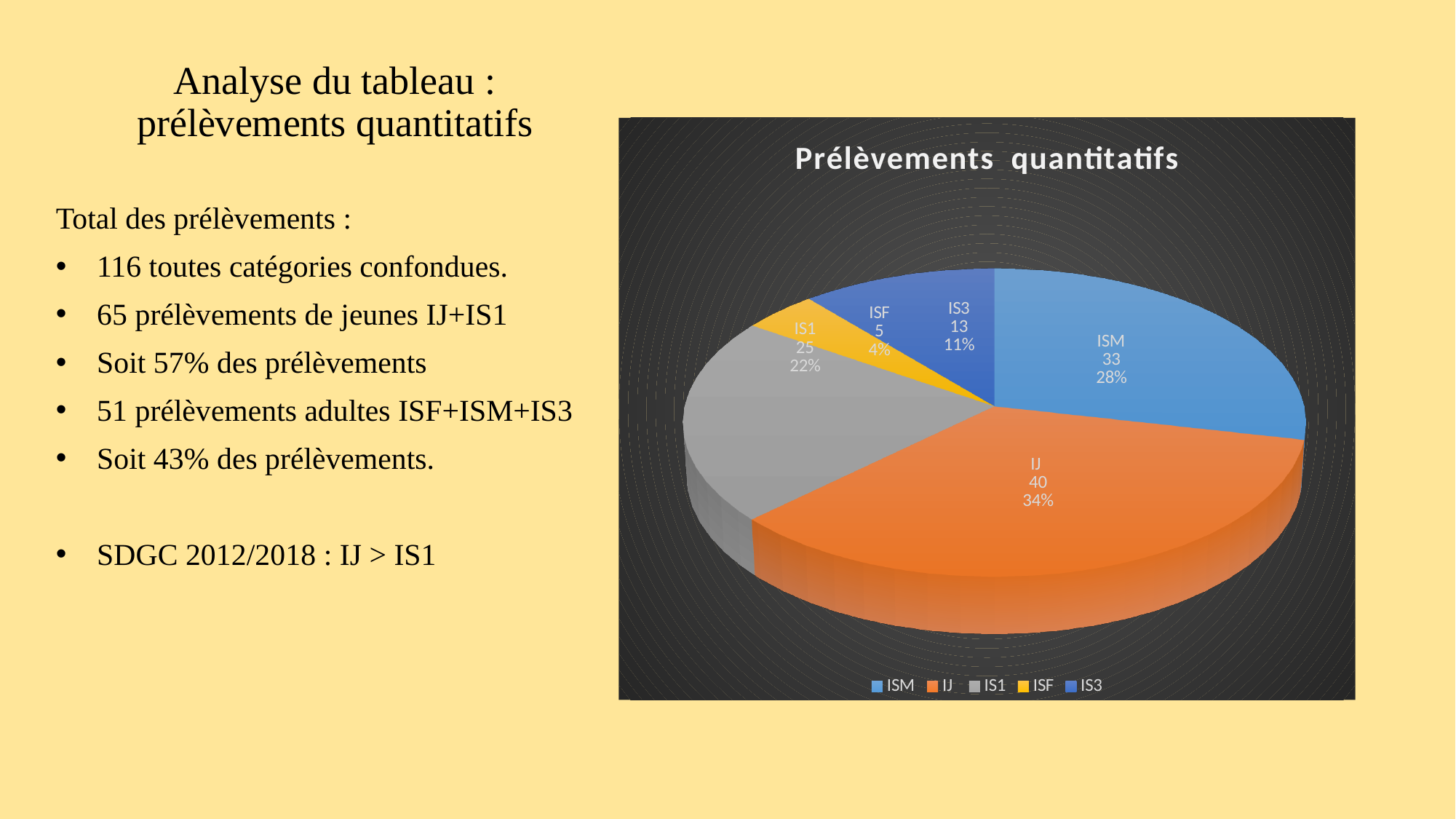
Which category has the smallest slice? ISF What is the difference between the values for IJ and IS1? 15 What kind of chart is shown on the slide? Pie chart Which category has the largest slice? IJ What is the value for IS1? 25 What is the value for IJ? 40 What share of the pie does IS3 represent? 11% How many categories does the pie chart have? 5 Which is larger, the value for ISM or the value for IS3? ISM What is the value for ISM? 33 What is the title of the chart? Prélèvements quantitatifs What is the value for ISF? 5